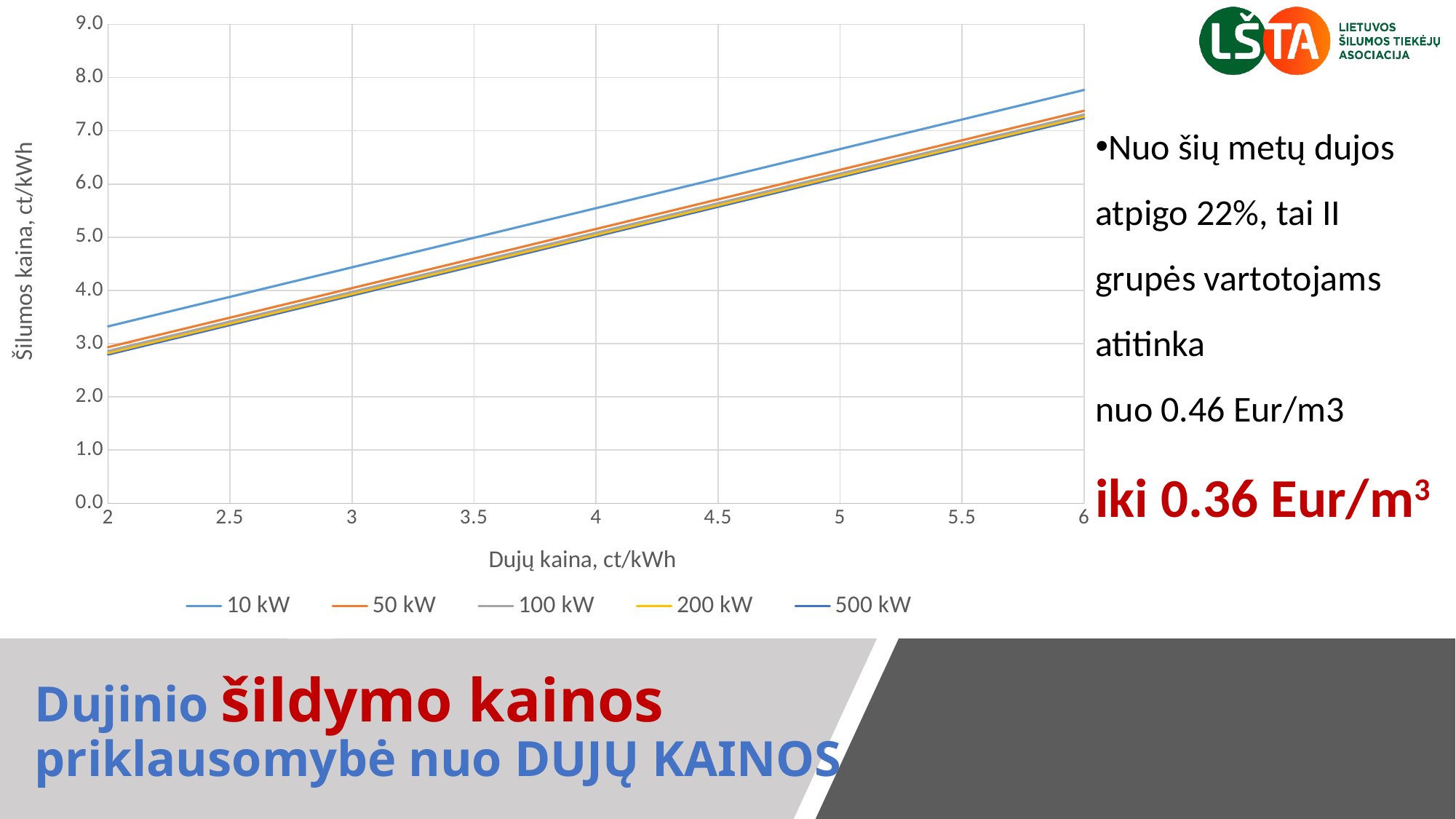
Is the value for the 500 kW series at a gas price of 2 ct/kWh greater or less than 3.0? less At a gas price of 6 ct/kWh, which series has the larger heat price, 10 kW or 500 kW? 10 kW Do the heat price lines rise or fall as the gas price increases along the x axis? rise What is the title of the chart's x axis? Dujų kaina, ct/kWh What is the title of the chart's y axis? Šilumos kaina, ct/kWh Is the value for the 10 kW series at a gas price of 4 ct/kWh greater or less than 5.0? greater Is the value for the 10 kW series at a gas price of 5 ct/kWh greater or less than 6.0? greater What kind of chart is shown on the slide? line chart Which series has the highest heat price across the whole gas price range? 10 kW How many series does the chart legend list? 5